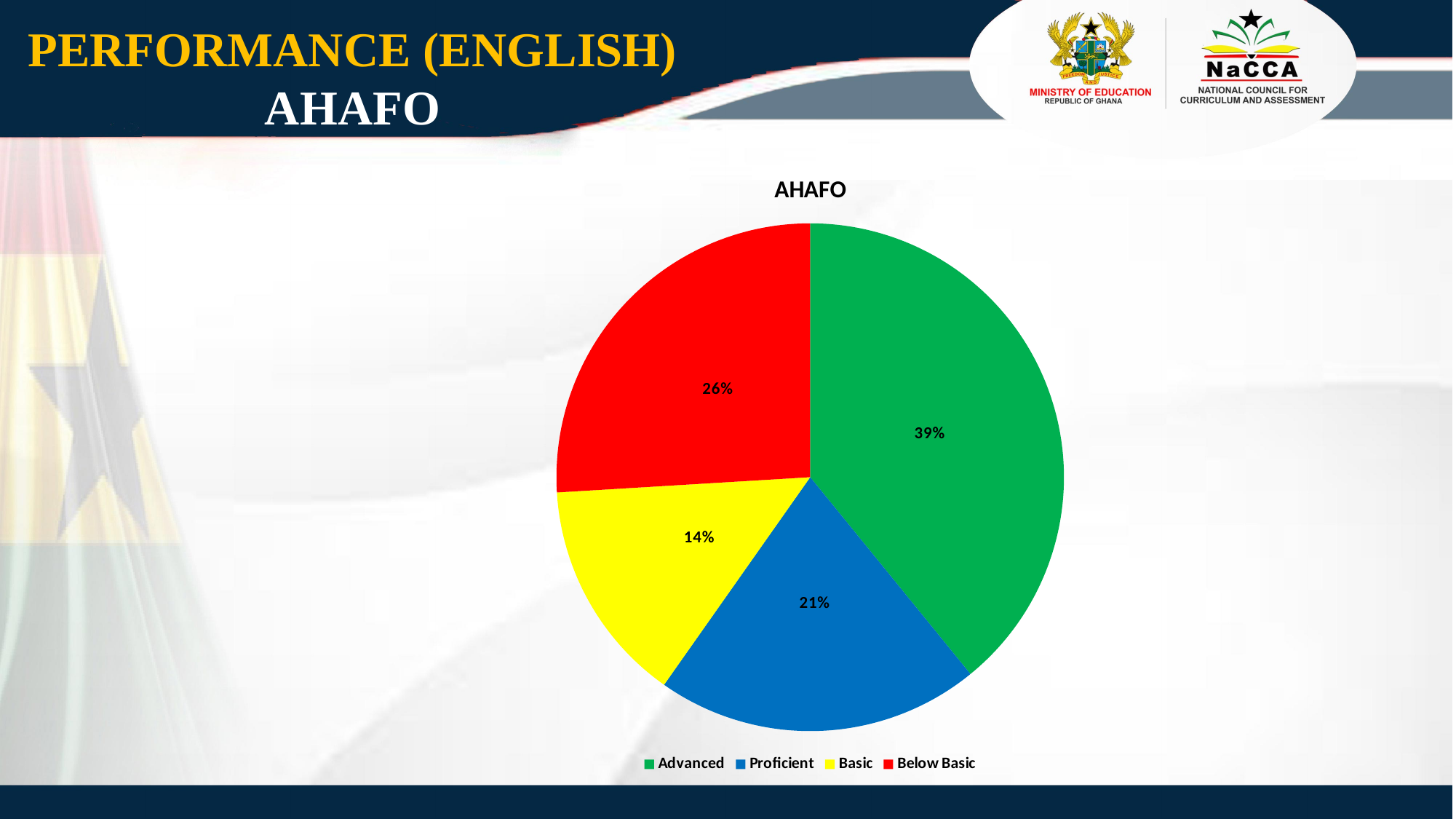
Which category has the smallest share of the pie chart? Basic What is the difference in percentage points between Advanced and Below Basic? 13 What kind of chart is shown on the slide? Pie chart Which category has the largest share of the pie chart? Advanced What percentage of the pie chart is Advanced? 39% How many categories does the pie chart show? 4 What is the title of the chart? AHAFO What colour represents Below Basic in the pie chart? Red What percentage of the pie chart is Basic? 14% Which is larger, the share for Proficient or the share for Basic? Proficient What percentage of the pie chart is Below Basic? 26% What percentage of the pie chart is Proficient? 21%